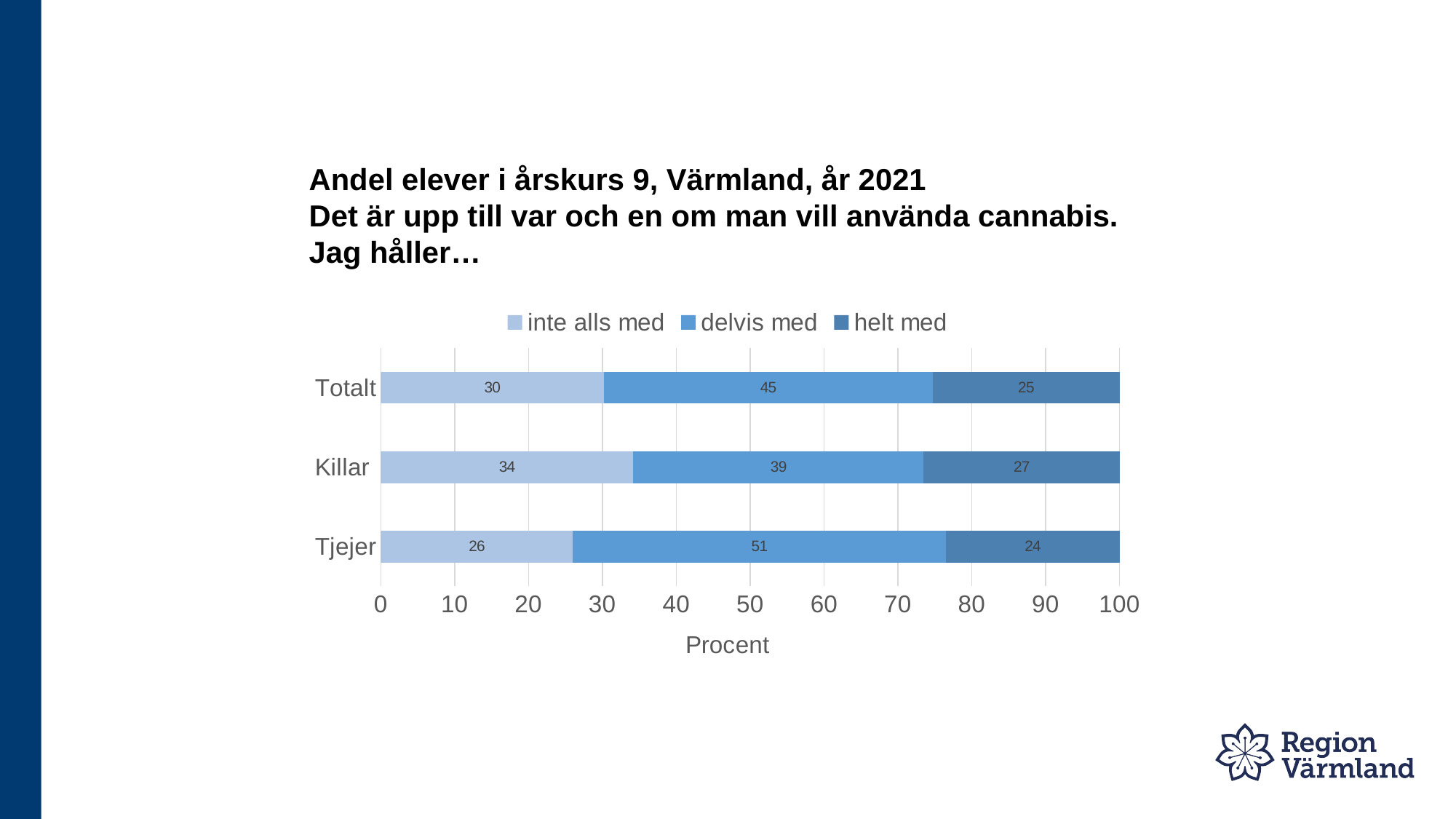
How many series does the legend list? 3 What is the value for 'delvis med' for Tjejer? 51 Which category has the lowest value for 'delvis med'? Killar What is the value for 'helt med' for Killar? 27 What is the total of the stacked bar for Totalt? 100 What is the label on the x axis? Procent Which is larger: 'helt med' for Killar or 'helt med' for Tjejer? Killar How many categories are shown on the y axis? 3 What is the difference between the 'delvis med' values for Tjejer and Killar? 12 What kind of chart is shown? Stacked bar chart Which category has the highest value for 'inte alls med'? Killar What is the value for 'inte alls med' for Totalt? 30